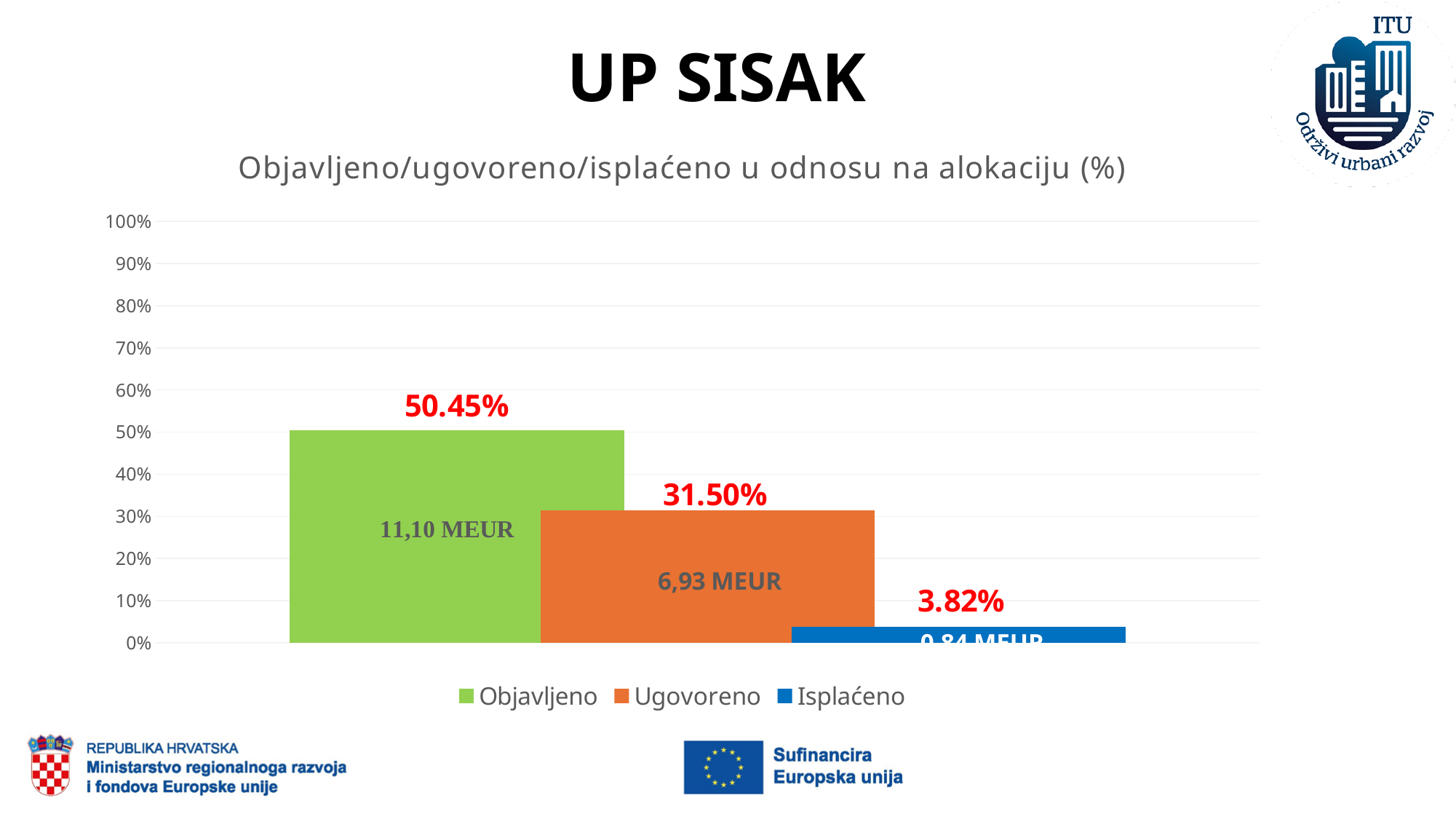
What is the value for Objavljeno? 50.45% How many series does the legend list? 3 What is the difference between the Objavljeno and Ugovoreno percentages? 18.95% What amount in MEUR is shown on the Ugovoreno bar? 6,93 MEUR Which series has the highest value? Objavljeno What is the value for Ugovoreno? 31.50% What is the value for Isplaćeno? 3.82% Which series has the lowest value? Isplaćeno What kind of chart is shown on the slide? Bar chart What amount in MEUR is shown on the Objavljeno bar? 11,10 MEUR Which is larger, the value for Ugovoreno or the value for Isplaćeno? Ugovoreno What is the title of the chart? Objavljeno/ugovoreno/isplaćeno u odnosu na alokaciju (%)